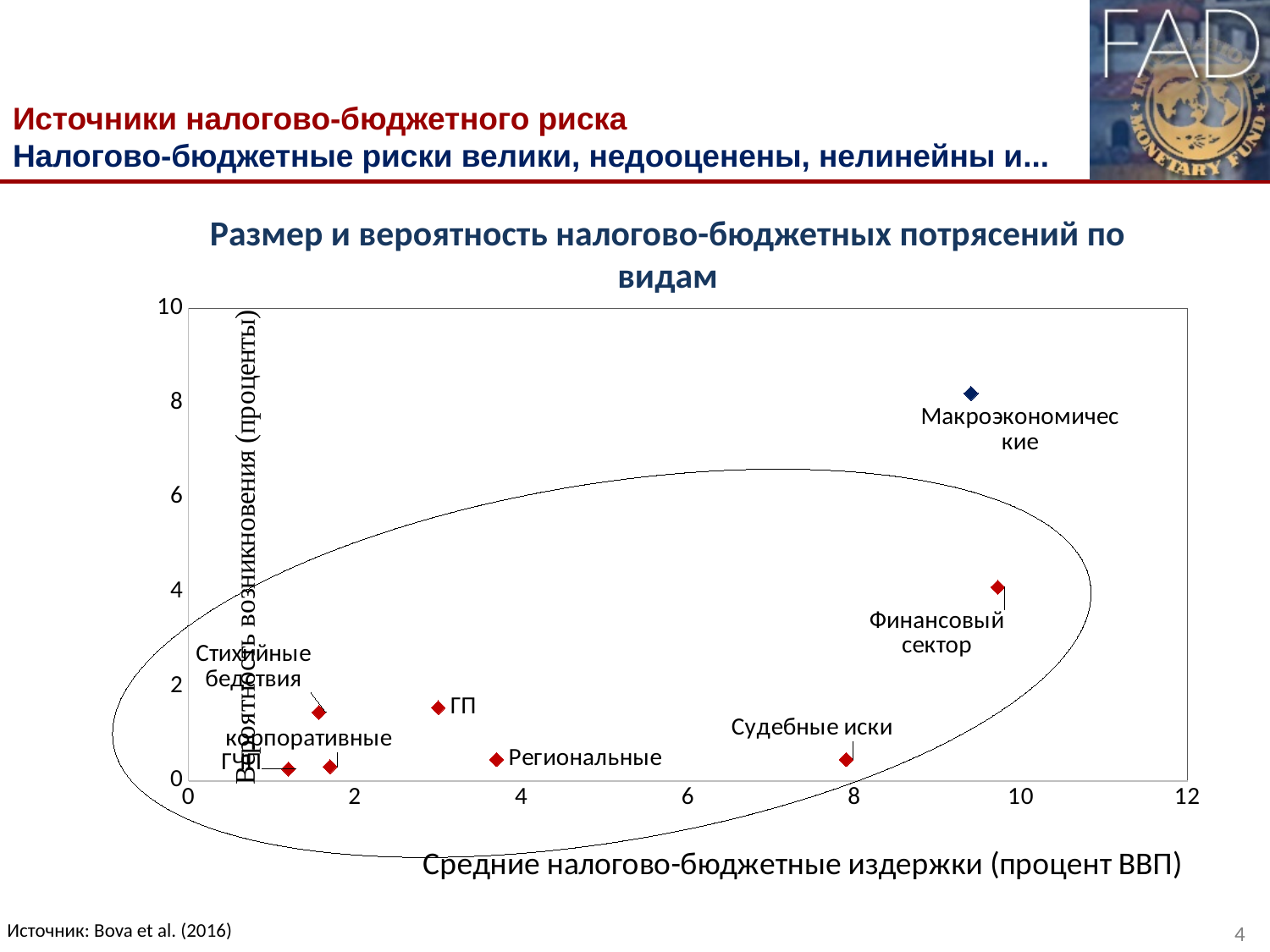
Is the probability of occurrence for ГП greater or less than 2? less Is the average fiscal cost for Макроэкономические greater or less than 8? greater What kind of chart is shown on the slide? Scatter chart Is the probability of occurrence for Макроэкономические greater or less than 6? greater Which category has the highest probability of occurrence (y axis) in the chart? Макроэкономические Which has a higher probability of occurrence, Макроэкономические or Финансовый сектор? Макроэкономические What is the title of the chart? Размер и вероятность налогово-бюджетных потрясений по видам Which has a higher average fiscal cost, Судебные иски or ГП? Судебные иски How many data points are plotted in the chart? 8 Which category has the lowest average fiscal cost (x axis) in the chart? ГЧП